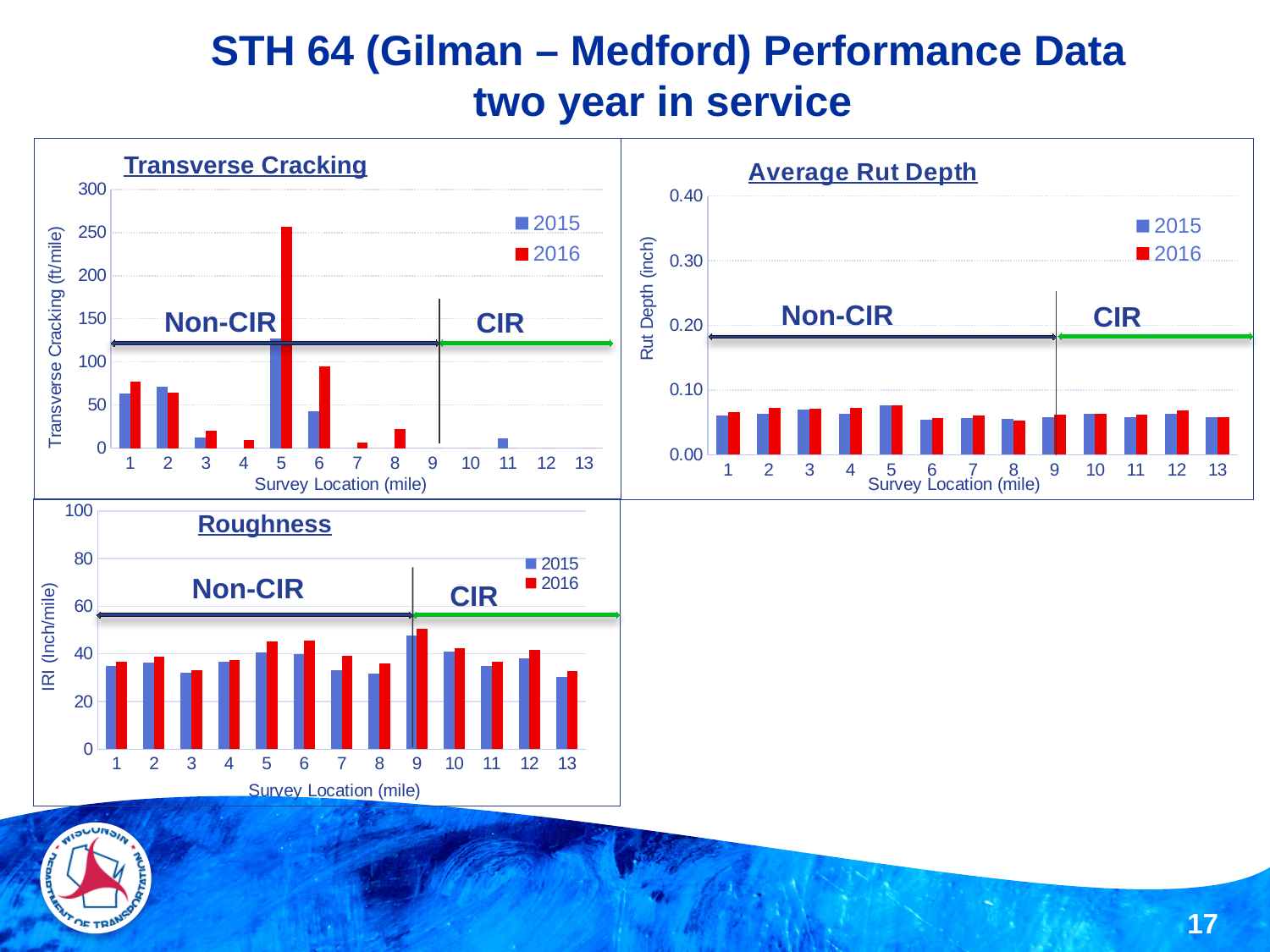
In the Average Rut Depth chart, is the 2016 value at survey location 1 greater or less than 0.10? less In the Transverse Cracking chart, which survey location has the highest 2016 value? 5 In the Transverse Cracking chart, is the 2016 value at survey location 5 greater or less than 200? greater In the Roughness chart, which survey location has the highest 2016 value? 9 How many series does the legend of the Average Rut Depth chart list? 2 How many survey locations are shown on the x axis of the Average Rut Depth chart? 13 In the Transverse Cracking chart, which is larger: the 2016 value at survey location 6 or the 2016 value at survey location 3? survey location 6 In the Roughness chart, is the 2016 value at survey location 9 greater or less than 40? greater What kind of chart is the Roughness chart? bar chart